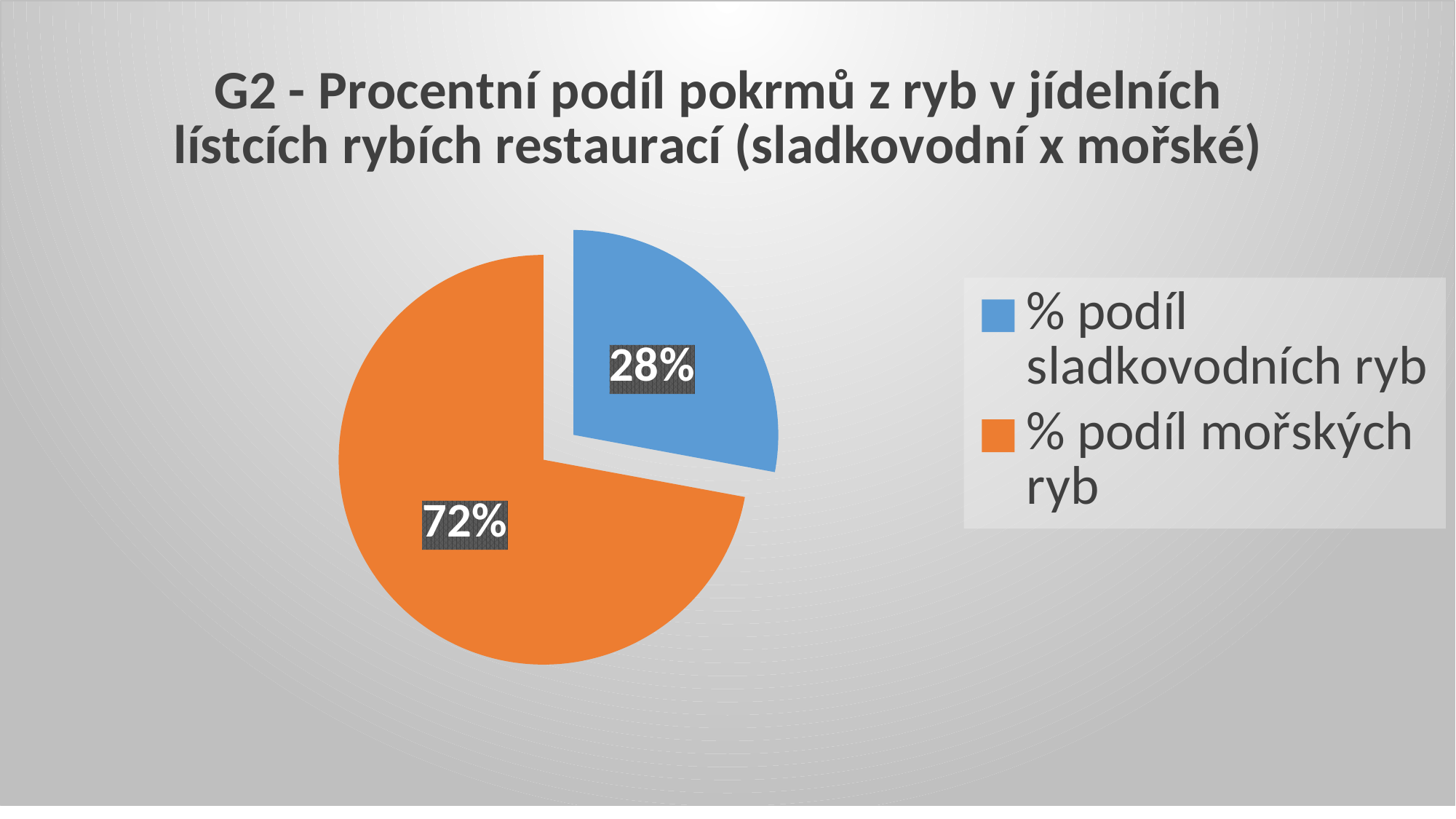
What type of chart is shown on the slide? pie chart What is the value for "% podíl sladkovodních ryb"? 28% What share of the pie does the blue slice represent? 28% How many entries does the legend list? 2 What colour is the slice for "% podíl mořských ryb"? orange How many slices does the pie chart have? 2 Which category has the largest share of the pie? % podíl mořských ryb What is the value for "% podíl mořských ryb"? 72% What is the title of the chart? G2 - Procentní podíl pokrmů z ryb v jídelních lístcích rybích restaurací (sladkovodní x mořské) Which category has the smallest share of the pie? % podíl sladkovodních ryb What is the difference between the share of "% podíl mořských ryb" and "% podíl sladkovodních ryb"? 44% Which is larger: the share of "% podíl sladkovodních ryb" or "% podíl mořských ryb"? % podíl mořských ryb